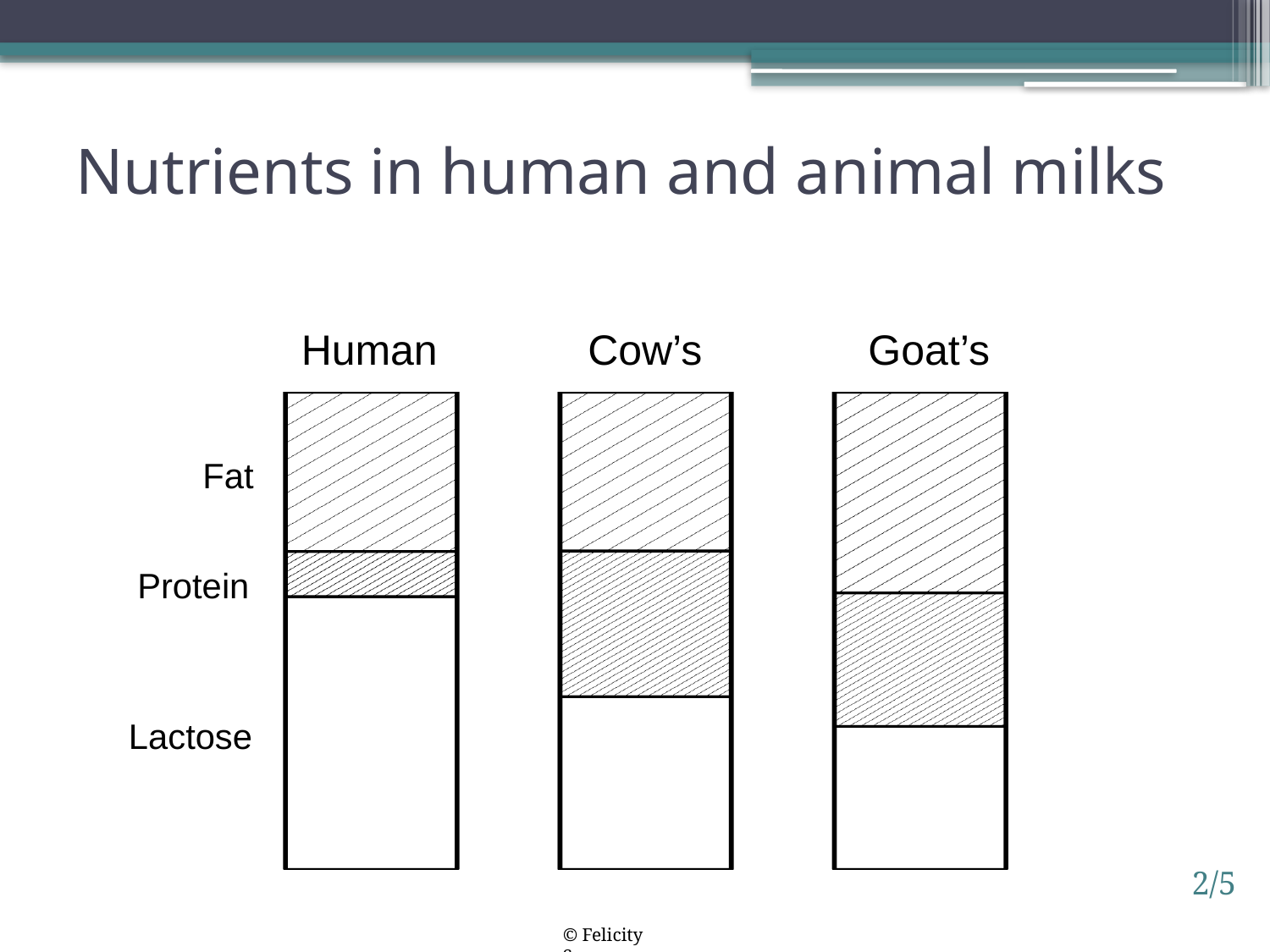
Which nutrients are shown as segments in each bar? Fat, Protein, Lactose Is the Fat segment larger for Goat's milk or Human milk? Goat's What kind of chart is shown on the slide? stacked bar chart How many nutrient segments make up each bar in the chart? 3 Which milk has the largest Lactose segment? Human Which milk has the smallest Lactose segment? Goat's Is the Protein segment larger for Human milk or Cow's milk? Cow's Is the Lactose segment larger for Human milk or Cow's milk? Human How many milk types (bars) are shown in the chart? 3 What is the title of the chart on the slide? Nutrients in human and animal milks Which milk has the largest Fat segment? Goat's Which milk has the smallest Protein segment? Human